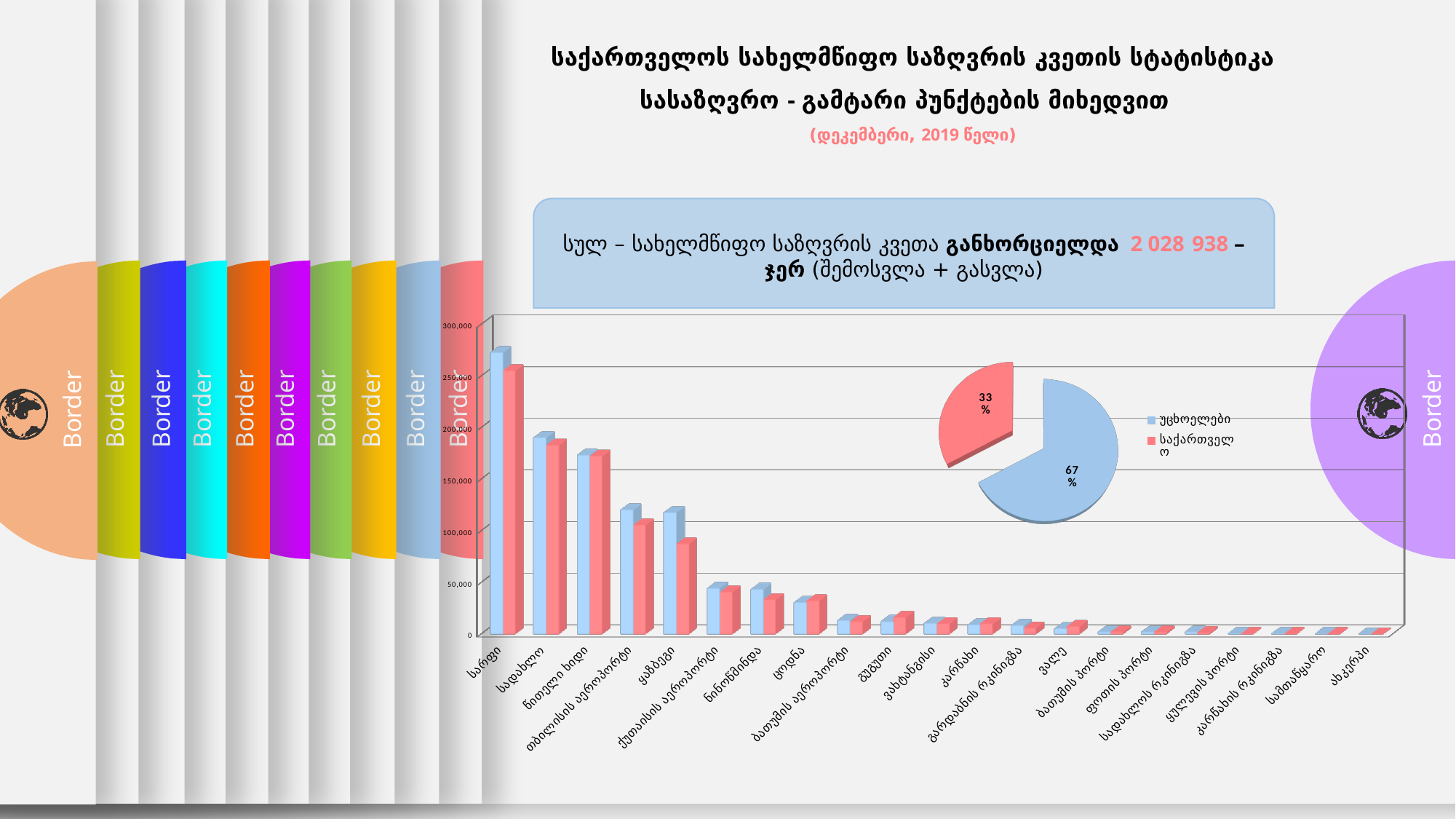
What kind of chart is the large chart at the bottom of the slide? bar chart In the pie chart, what share is shown for უცხოელები? 67% How many categories are shown on the x axis of the bar chart? 21 What kind of chart is the chart on the right with the 33% and 67% slices? pie chart How many series does the legend of the pie chart list? 2 In the bar chart, do the values generally rise or fall from left to right along the x axis? fall In the pie chart, which slice is larger, უცხოელები or საქართველო? უცხოელები In the bar chart, which category has the highest values? სარფი In the pie chart, what share is shown for საქართველო? 33%